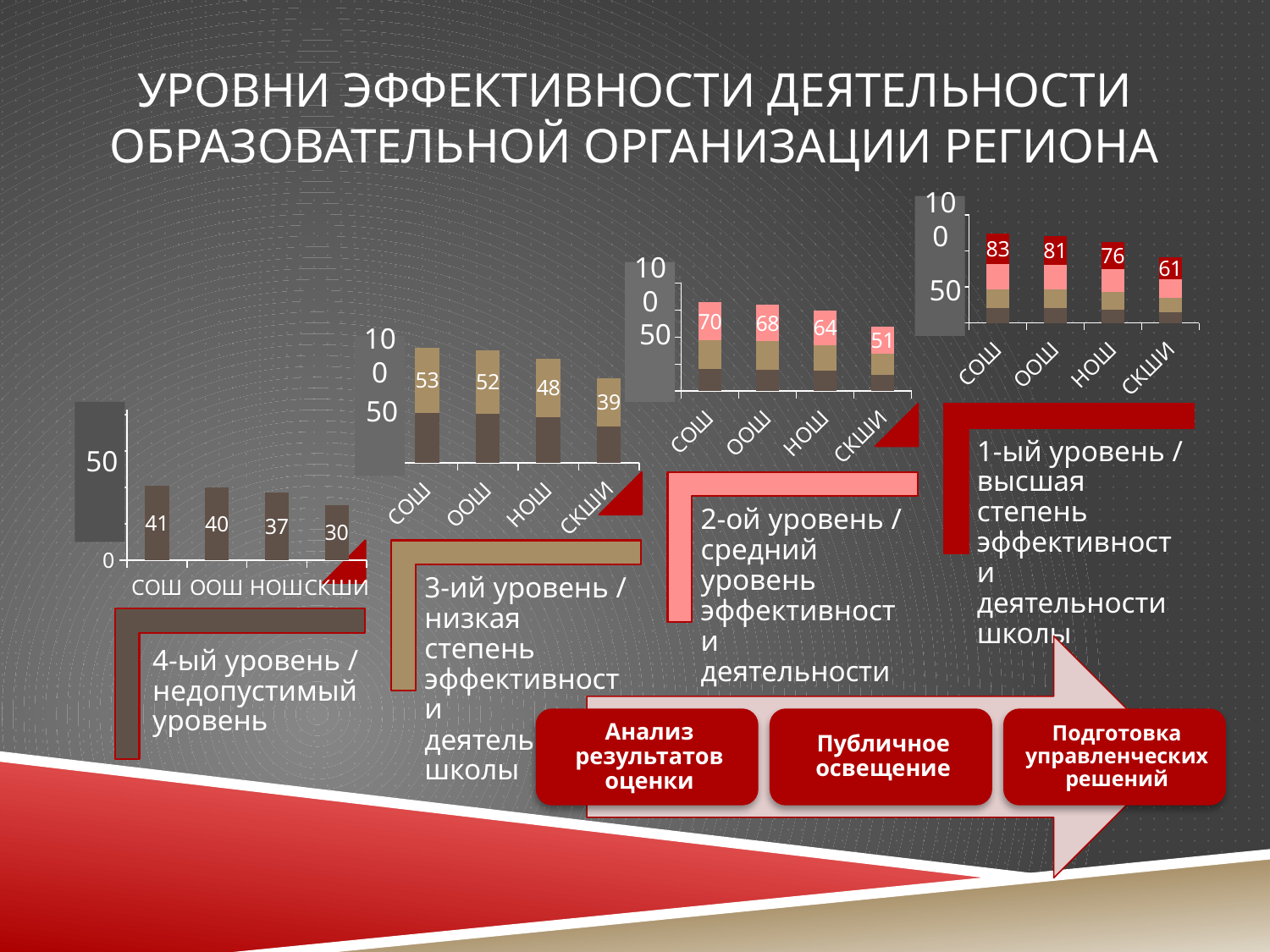
In the third chart from the left (2-ой уровень), what is the value for ООШ? 68 In the rightmost chart (1-ый уровень), which is larger, the value for НОШ or the value for СКШИ? НОШ In the rightmost chart (1-ый уровень), what is the value for СКШИ? 61 How many categories are shown in the leftmost chart (4-ый уровень)? 4 In the second chart from the left (3-ий уровень), what is the difference between the values for СОШ and СКШИ? 14 In the leftmost chart (4-ый уровень), which category has the lowest value? СКШИ In the third chart from the left (2-ой уровень), which category has the highest value? СОШ In the rightmost chart (1-ый уровень), what is the difference between the values for СОШ and ООШ? 2 In the third chart from the left (2-ой уровень), do the values rise or fall from СОШ to СКШИ? Fall What type of chart is the rightmost chart (1-ый уровень)? Bar chart In the second chart from the left (3-ий уровень), what is the value for НОШ? 48 In the leftmost chart (4-ый уровень), what is the value for СОШ? 41